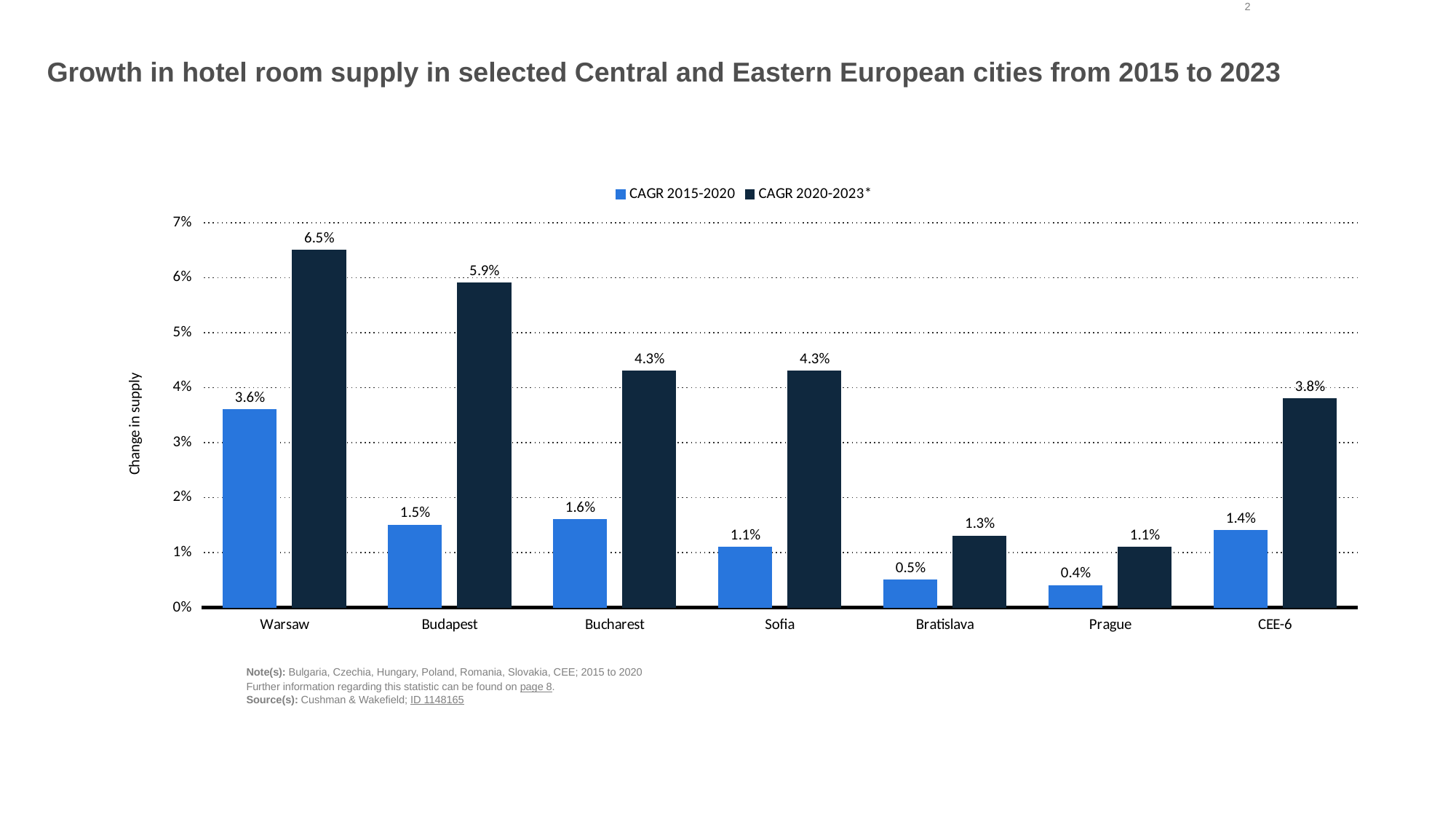
What is the CAGR 2015-2020 value for Warsaw? 3.6% Which category has the lowest CAGR 2015-2020 value? Prague How many series does the legend list? 2 What kind of chart is shown on the slide? Bar chart Which is larger for Bucharest: CAGR 2015-2020 or CAGR 2020-2023*? CAGR 2020-2023* Which city has the highest CAGR 2020-2023* value? Warsaw How many categories are shown on the x axis? 7 What is the label of the y axis? Change in supply What is the difference between the CAGR 2020-2023* and CAGR 2015-2020 values for Warsaw? 2.9% What is the CAGR 2015-2020 value for Prague? 0.4% What is the CAGR 2020-2023* value for CEE-6? 3.8% What is the CAGR 2020-2023* value for Budapest? 5.9%